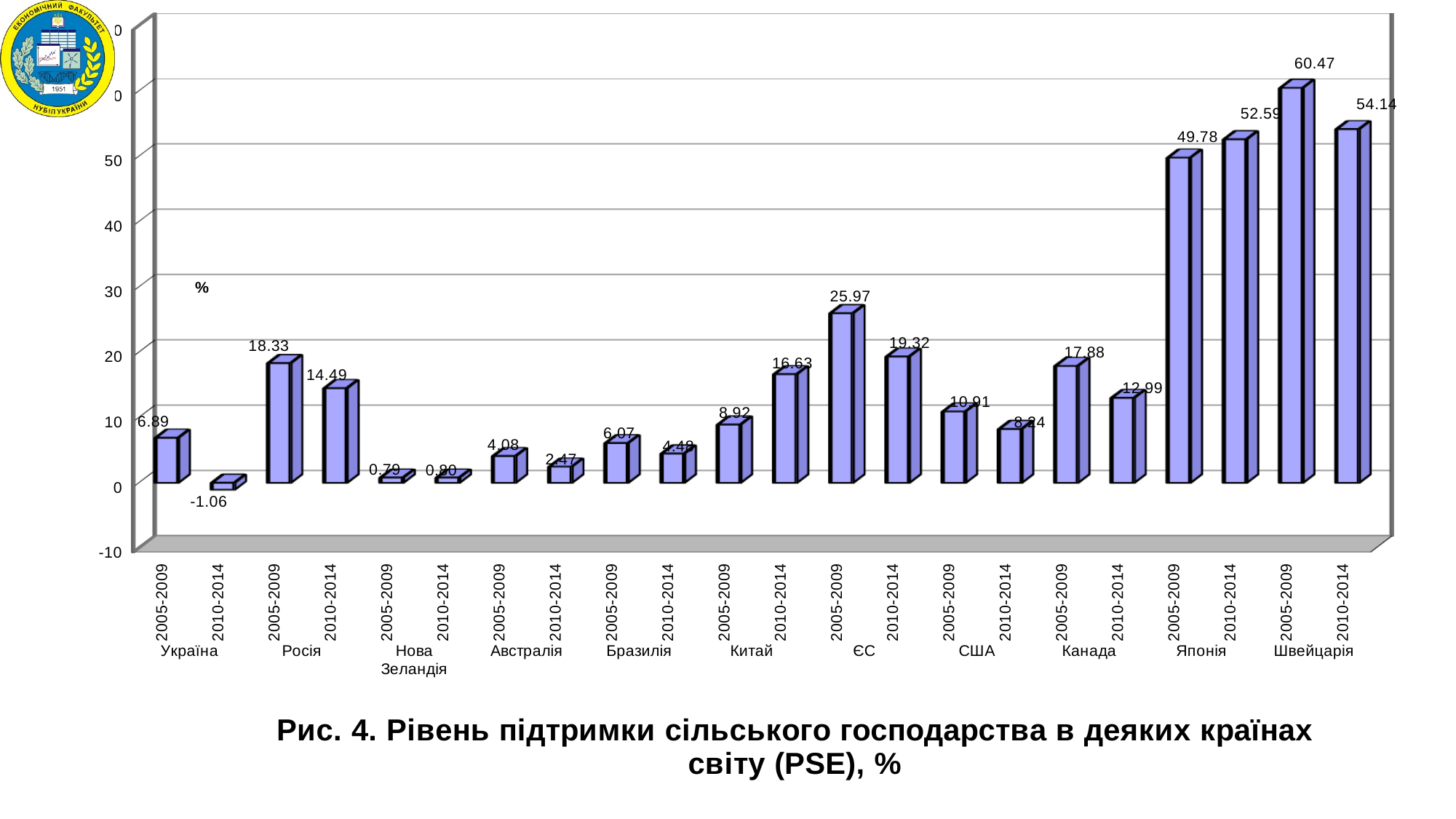
What is the difference between the values for Росія in 2005-2009 and 2010-2014? 3.84 Which bar has the highest value on the chart? Швейцарія 2005-2009 Is the value for Японія in 2005-2009 greater or less than 40? greater What kind of chart is shown on the slide? bar chart What is the value for ЄС in 2005-2009? 25.97 How many countries are shown on the x axis? 11 Which bar has the lowest value on the chart? Україна 2010-2014 What is the value for Японія in 2010-2014? 52.59 What is the title of the chart? Рис. 4. Рівень підтримки сільського господарства в деяких країнах світу (PSE), % What is the value for Україна in 2005-2009? 6.89 Which is larger: the value for Китай in 2010-2014 or the value for Канада in 2010-2014? Китай 2010-2014 What is the value for Швейцарія in 2005-2009? 60.47